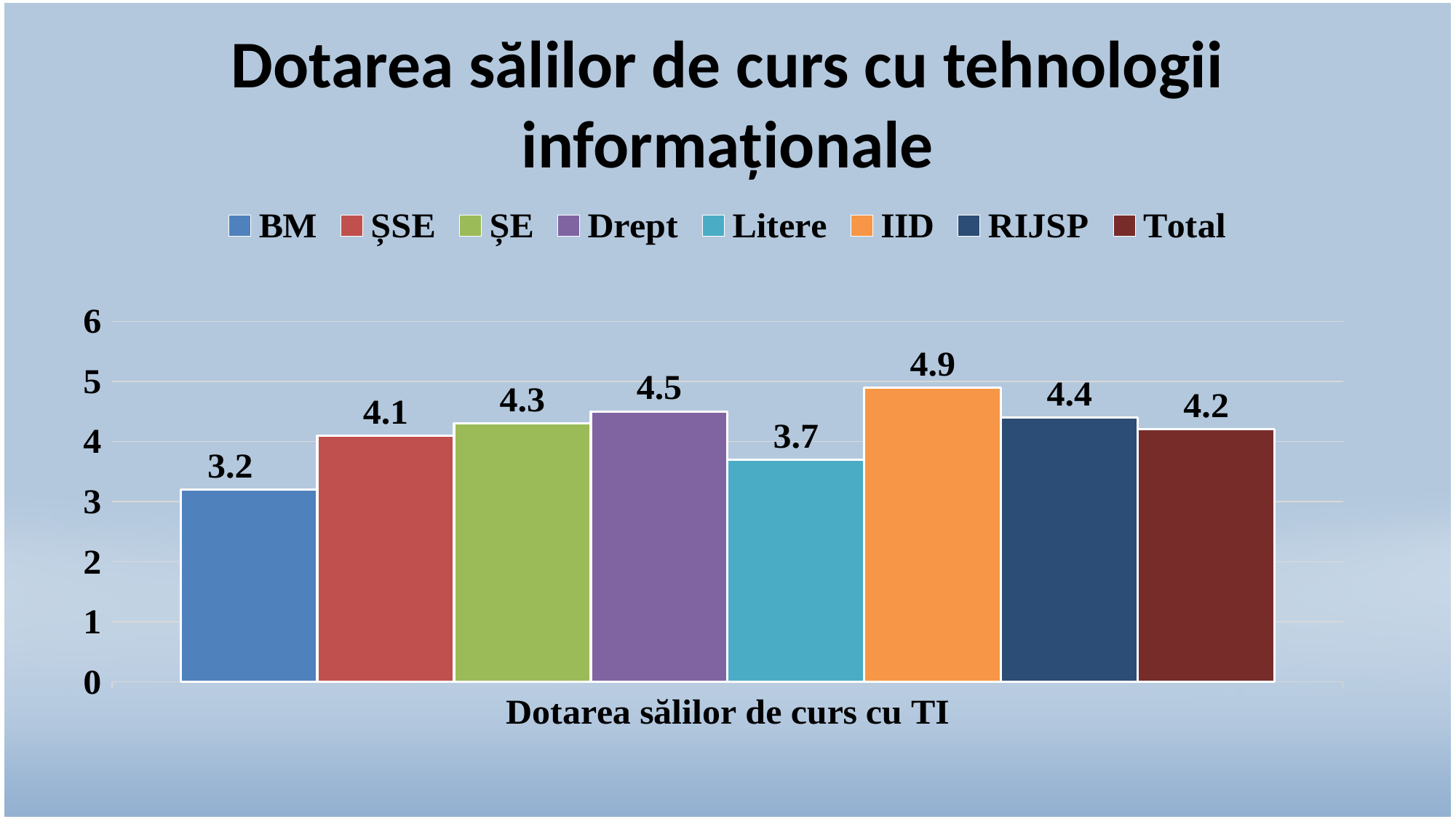
What kind of chart is shown on the slide? bar chart What is the value for IID? 4.9 Is the value for ȘSE greater or less than 4? greater Which is larger, the value for Drept or the value for RIJSP? Drept What is the value for BM? 3.2 What is the title of the chart? Dotarea sălilor de curs cu tehnologii informaționale How many series does the legend list? 8 What is the value for Total? 4.2 Which series has the highest value? IID What is the value for Litere? 3.7 Which series has the lowest value? BM What is the difference between the values for IID and BM? 1.7